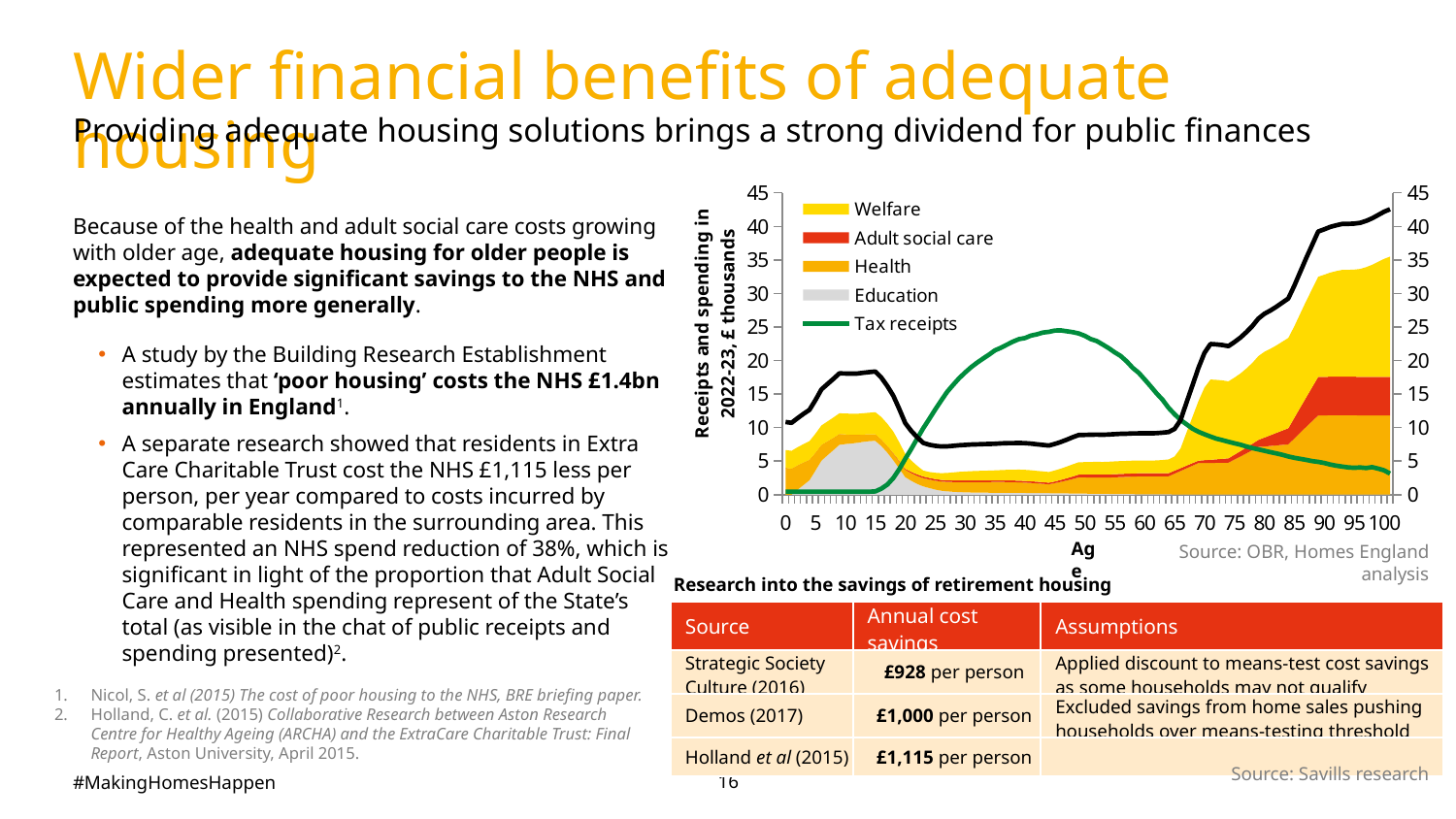
Is the value of Tax receipts at age 45 greater or less than 20? greater How many series does the chart legend list? 5 What is the highest value shown on the chart's vertical axis? 45 What is the label of the chart's vertical axis? Receipts and spending in 2022-23, £ thousands Is the value of Tax receipts larger at age 45 or at age 100? age 45 Is the value of Tax receipts at age 100 greater or less than 10? less Is the value of Tax receipts at age 0 greater or less than 5? less Do Tax receipts rise or fall between age 45 and age 100? fall What variable is plotted on the chart's horizontal axis? Age What kind of chart is shown on the slide? Stacked area chart with a line Do Tax receipts rise or fall between age 20 and age 45? rise